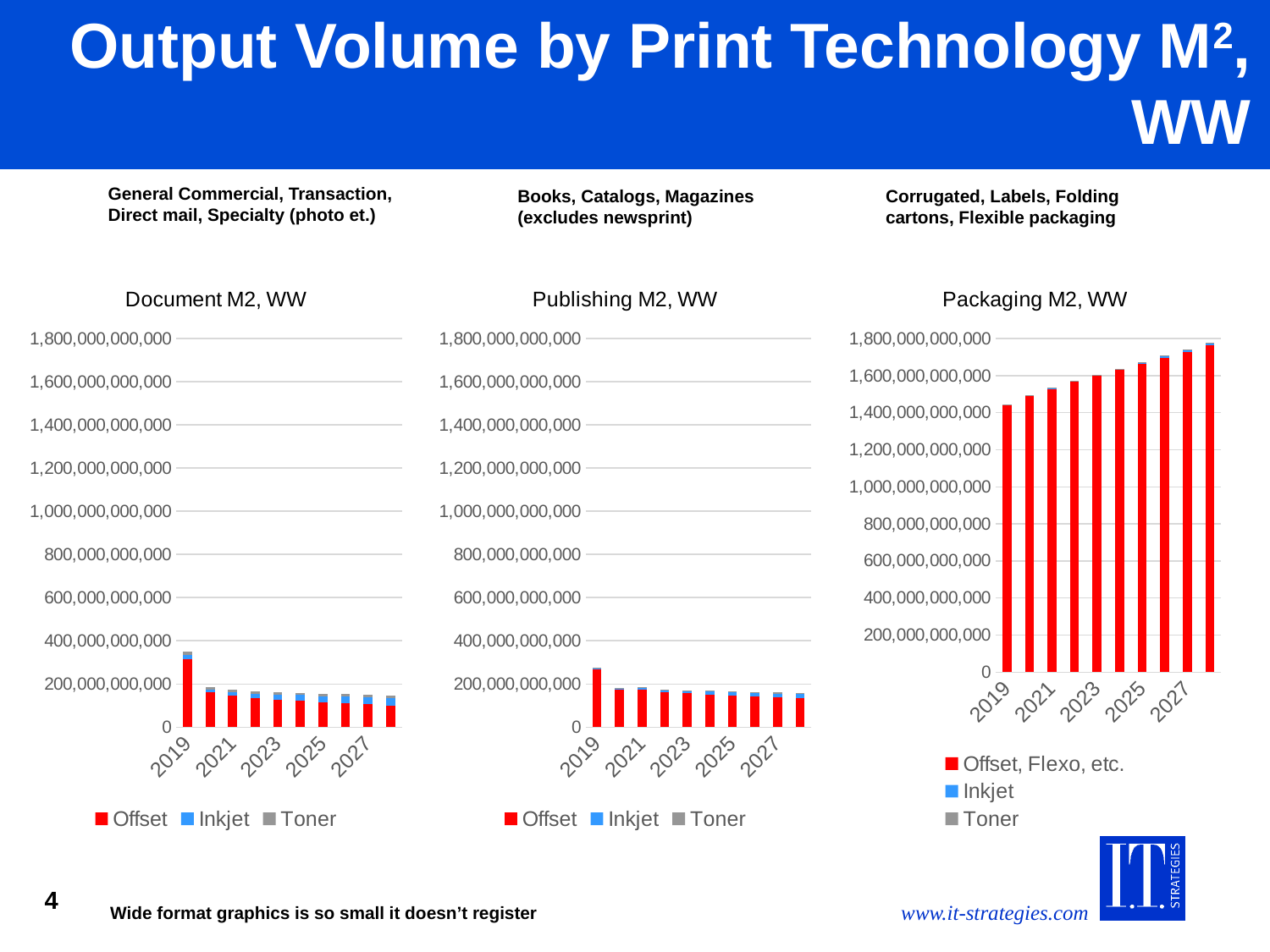
In the Packaging M2, WW chart, is the total for 2027 greater or less than 1,600,000,000,000? greater In the Packaging M2, WW chart, do the bar totals rise or fall from 2019 to 2027? Rise How many series does the legend of the Publishing M2, WW chart list? 3 How many bars (years) are plotted in the Packaging M2, WW chart? 10 In the Document M2, WW chart, do the bar totals rise or fall from 2019 to 2027? Fall In the Publishing M2, WW chart, which year has the highest total bar? 2019 In the Packaging M2, WW chart, which year has the lowest total bar? 2019 What kind of chart is the Document M2, WW chart? Stacked bar chart In the Document M2, WW chart, is the total for 2019 greater or less than 200,000,000,000? greater In the Packaging M2, WW chart, which year has the highest total bar? 2028 What is the first legend entry of the Packaging M2, WW chart? Offset, Flexo, etc. Which is larger: the 2019 total in the Packaging M2, WW chart or the 2019 total in the Document M2, WW chart? Packaging M2, WW